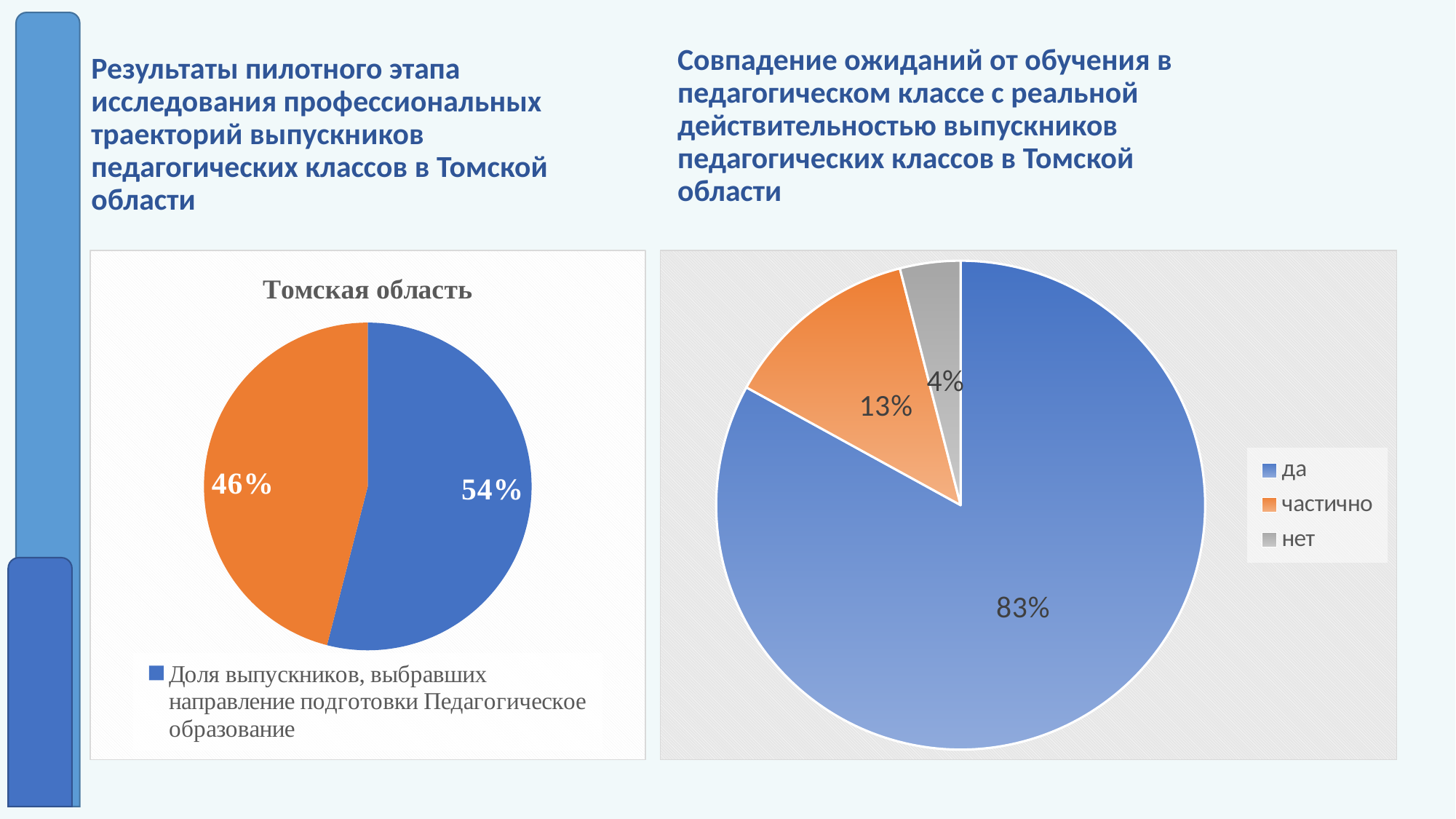
How many categories does the legend of the right chart list? 3 In the right chart, what share is shown for "да"? 83% What kind of chart is the left chart titled "Томская область"? pie chart In the left chart titled "Томская область", what share is shown for "Доля выпускников, выбравших направление подготовки Педагогическое образование"? 54% In the left chart titled "Томская область", what is the difference between the two slices' percentages? 8% What kind of chart is the right chart on the slide? pie chart In the left chart titled "Томская область", what percentage is shown on the orange slice? 46% In the right chart, which category has the smallest slice? нет In the right chart, what share is shown for "частично"? 13% In the right chart, what is the difference between the shares for "частично" and "нет"? 9% In the right chart, which category has the largest slice? да